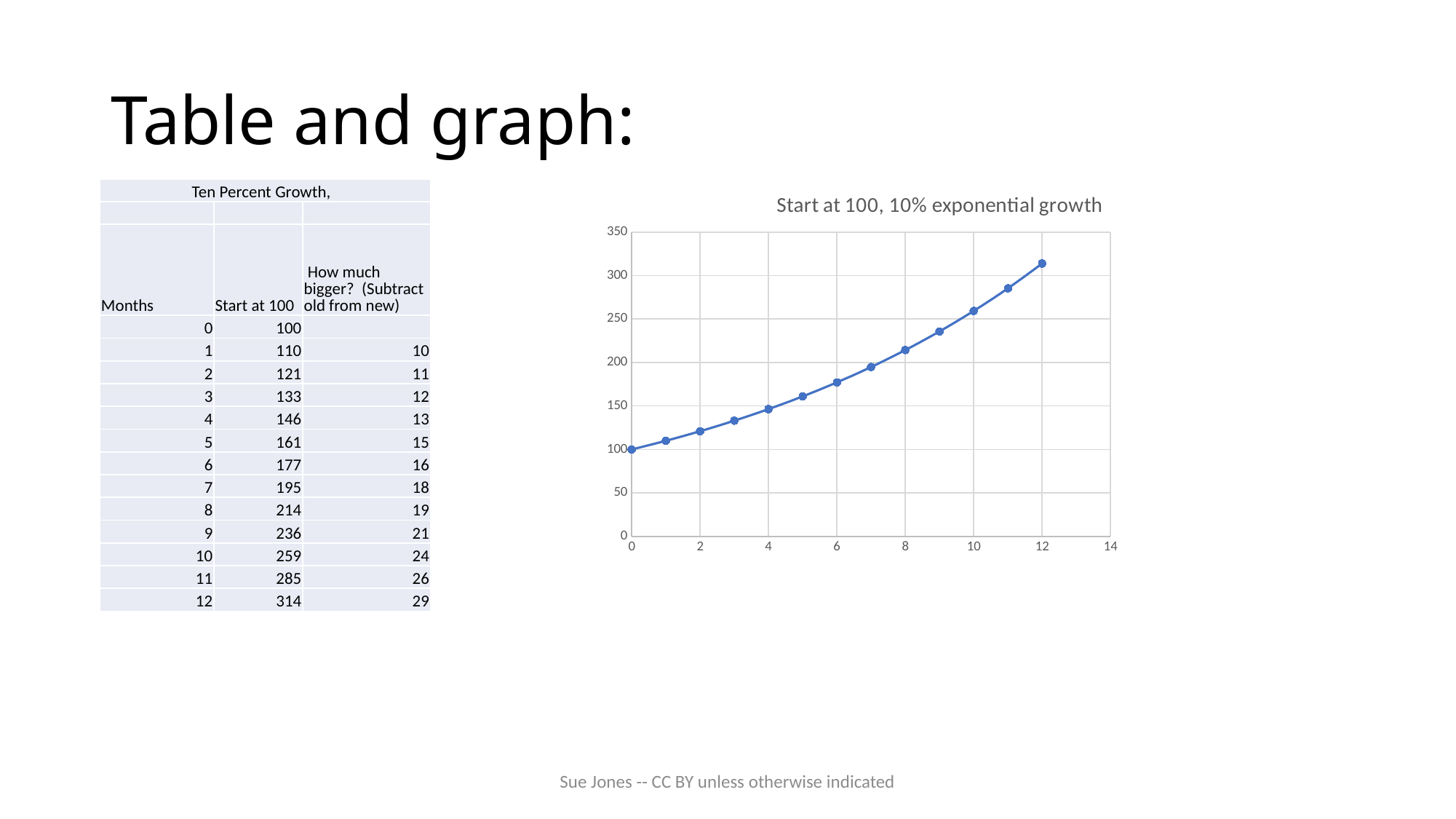
Is the plotted value at month 12 greater or less than 300? greater At which month is the plotted value lowest? 0 Is the plotted value at month 4 greater or less than 150? less Is the plotted value at month 6 greater or less than 200? less How many data points are plotted on the chart? 13 At which month is the plotted value highest? 12 What is the title of the chart? Start at 100, 10% exponential growth What kind of chart is shown on the slide? line chart Which has the larger plotted value, month 3 or month 9? month 9 Do the plotted values rise or fall as the months increase along the x axis? rise What is the plotted value at month 0? 100